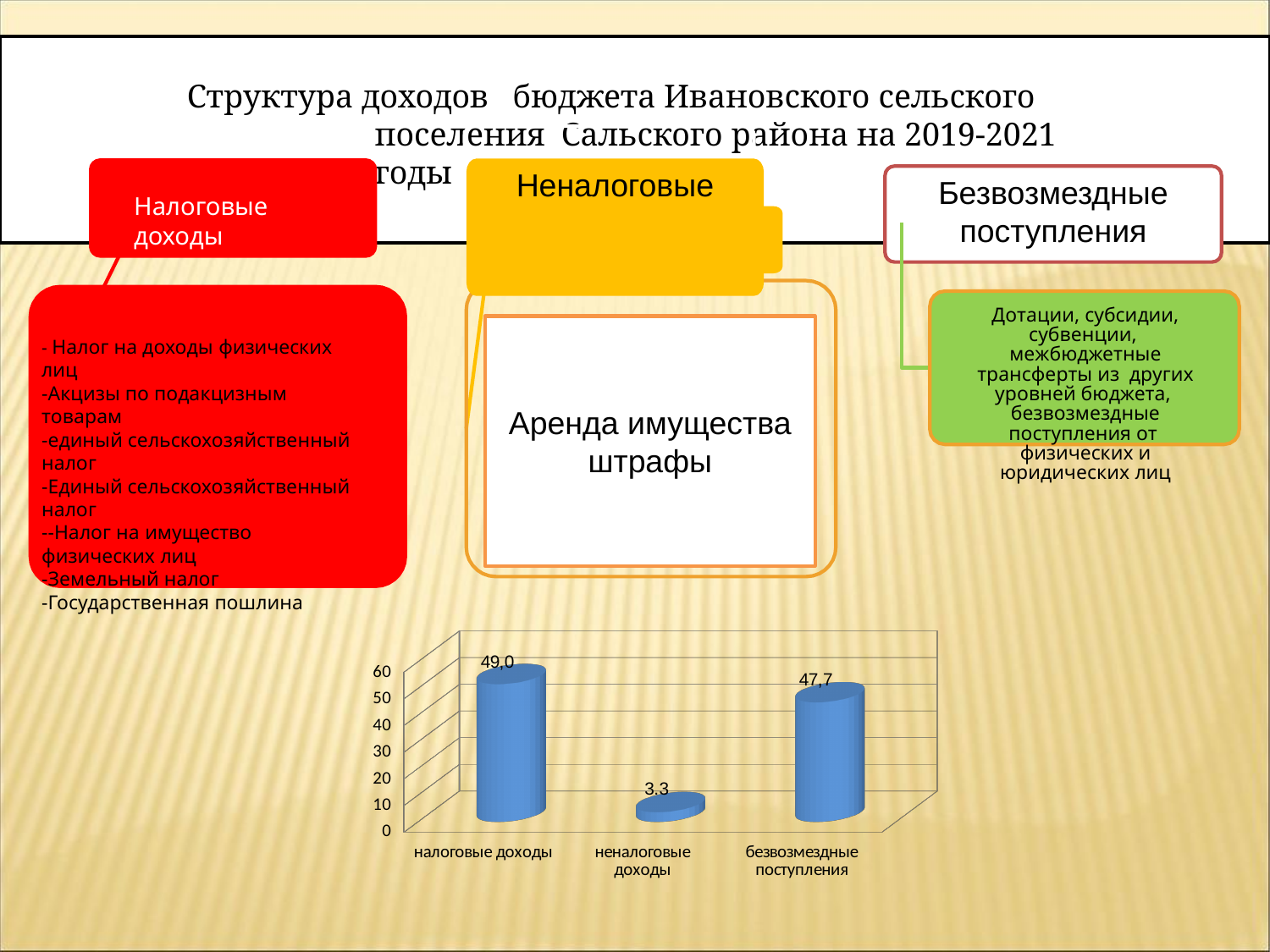
What is the value for налоговые доходы? 49,0 Is the value for неналоговые доходы greater or less than 10? less Which is larger, the value for неналоговые доходы or the value for безвозмездные поступления? безвозмездные поступления What is the highest value shown on the vertical axis of the chart? 60 What is the value for безвозмездные поступления? 47,7 How many categories are shown on the chart? 3 What kind of chart is shown on the slide? bar chart What is the difference between the values for безвозмездные поступления and неналоговые доходы? 44,4 What is the difference between the values for налоговые доходы and безвозмездные поступления? 1,3 What is the value for неналоговые доходы? 3,3 Which category has the highest value? налоговые доходы Which category has the lowest value? неналоговые доходы